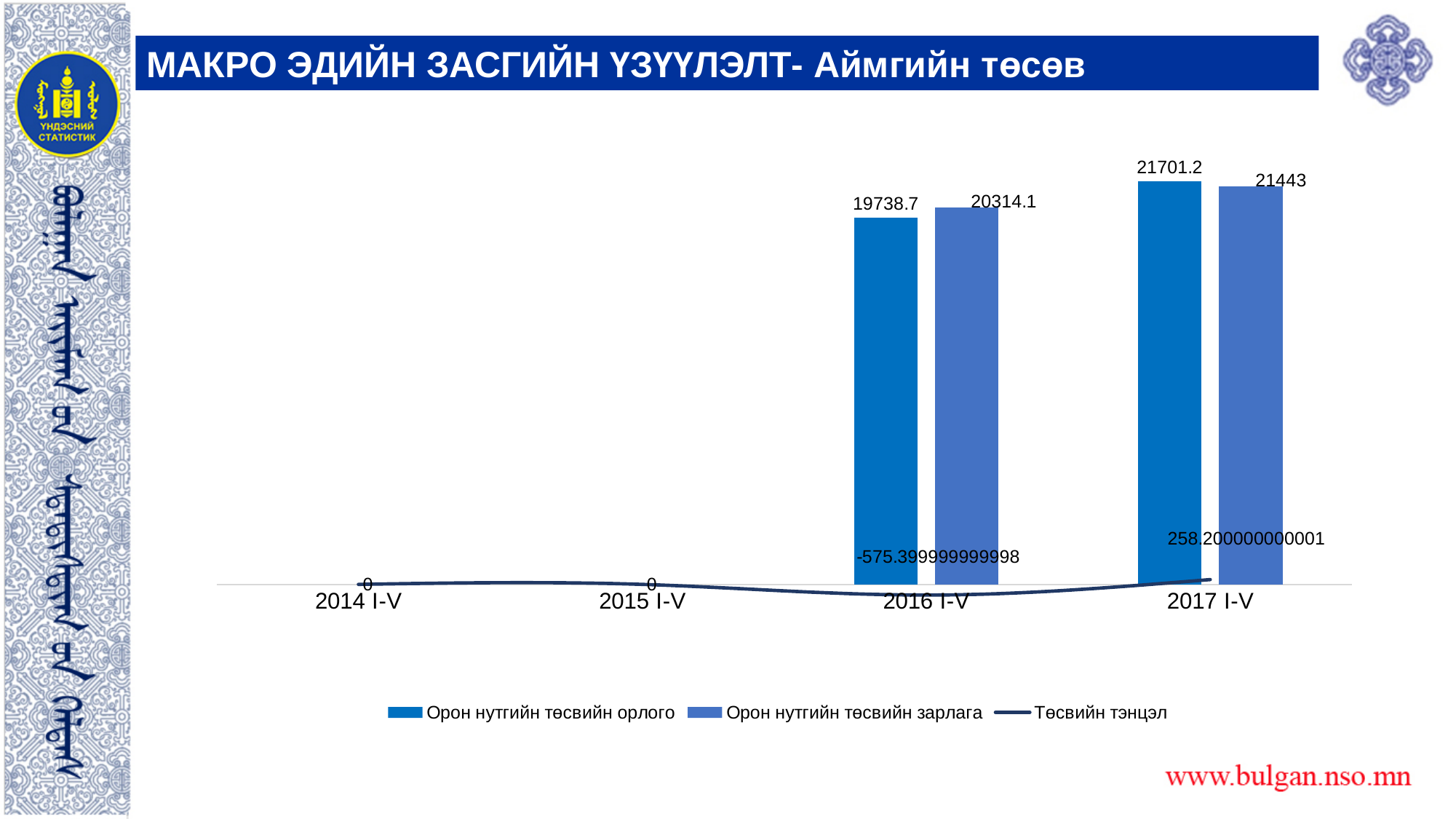
What is the difference between Орон нутгийн төсвийн орлого for 2017 I-V and 2016 I-V? 1962.5 What is the value of Төсвийн тэнцэл for 2016 I-V? -575.399999999998 What is the value of Төсвийн тэнцэл for 2017 I-V? 258.200000000001 What is the value of Орон нутгийн төсвийн зарлага for 2016 I-V? 20314.1 Which series in the chart is drawn as a line rather than bars? Төсвийн тэнцэл How many series does the chart legend list? 3 Which is larger for 2017 I-V: Орон нутгийн төсвийн орлого or Орон нутгийн төсвийн зарлага? Орон нутгийн төсвийн орлого What is the value of Орон нутгийн төсвийн зарлага for 2017 I-V? 21443 Which is larger for 2016 I-V: Орон нутгийн төсвийн орлого or Орон нутгийн төсвийн зарлага? Орон нутгийн төсвийн зарлага Which period has the highest value for Орон нутгийн төсвийн орлого? 2017 I-V How many periods are shown on the x axis of the chart? 4 What is the value of Орон нутгийн төсвийн орлого for 2016 I-V? 19738.7